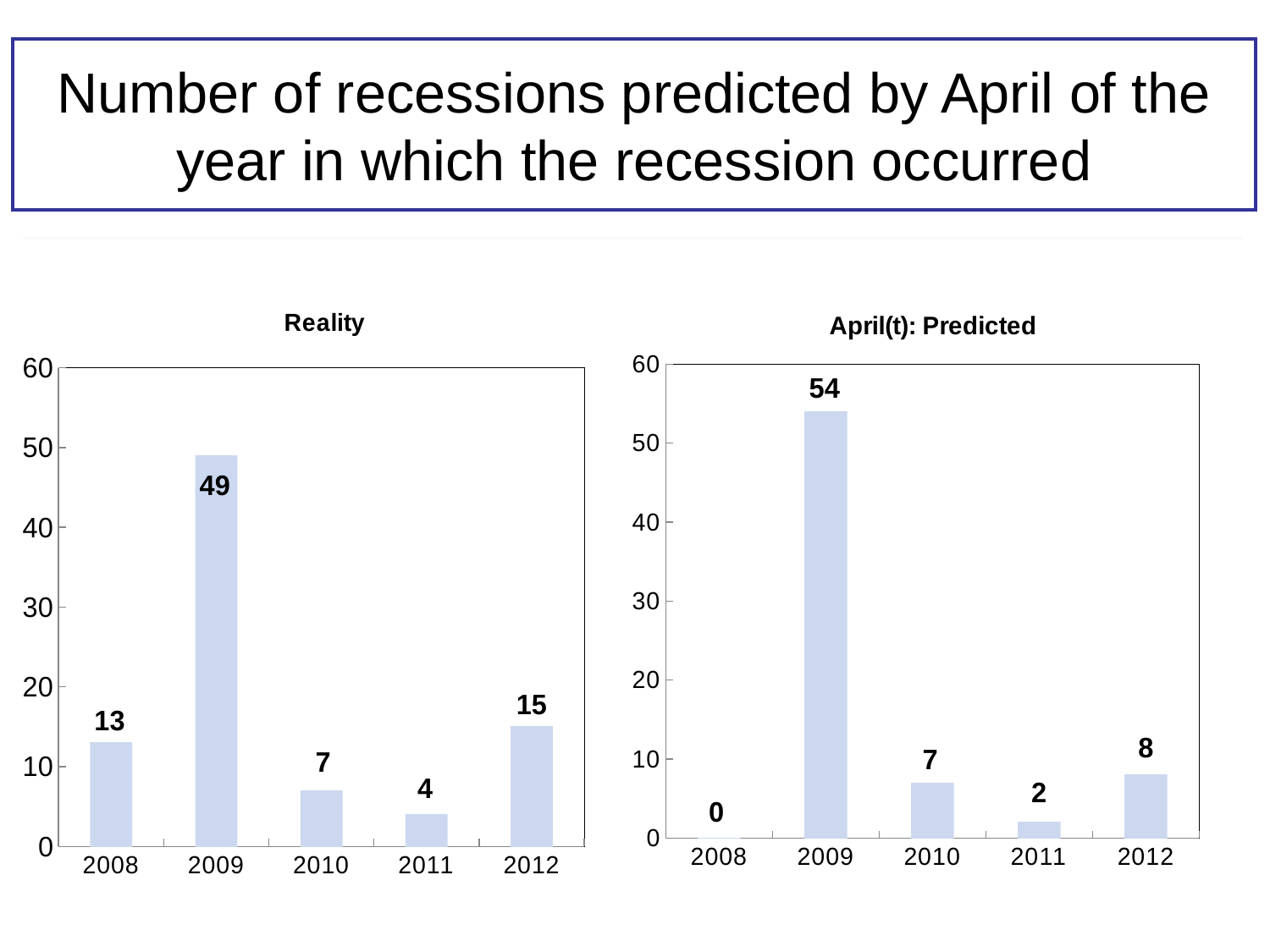
In the 'Reality' chart, is the value for 2009 greater or less than 40? greater In the 'Reality' chart, what is the value for 2010? 7 What is the title of the chart on the left of the slide? Reality In the 'April(t): Predicted' chart, what is the difference between the values for 2009 and 2012? 46 In the 'April(t): Predicted' chart, what is the value for 2008? 0 What kind of chart is the 'April(t): Predicted' chart? bar chart In the 'Reality' chart, what is the value for 2009? 49 In the 'April(t): Predicted' chart, which is larger, the value for 2010 or the value for 2011? 2010 In the 'Reality' chart, which year has the lowest value? 2011 In the 'April(t): Predicted' chart, which year has the highest value? 2009 How many years are shown on the x axis of the 'Reality' chart? 5 In the 'Reality' chart, what is the difference between the values for 2012 and 2008? 2